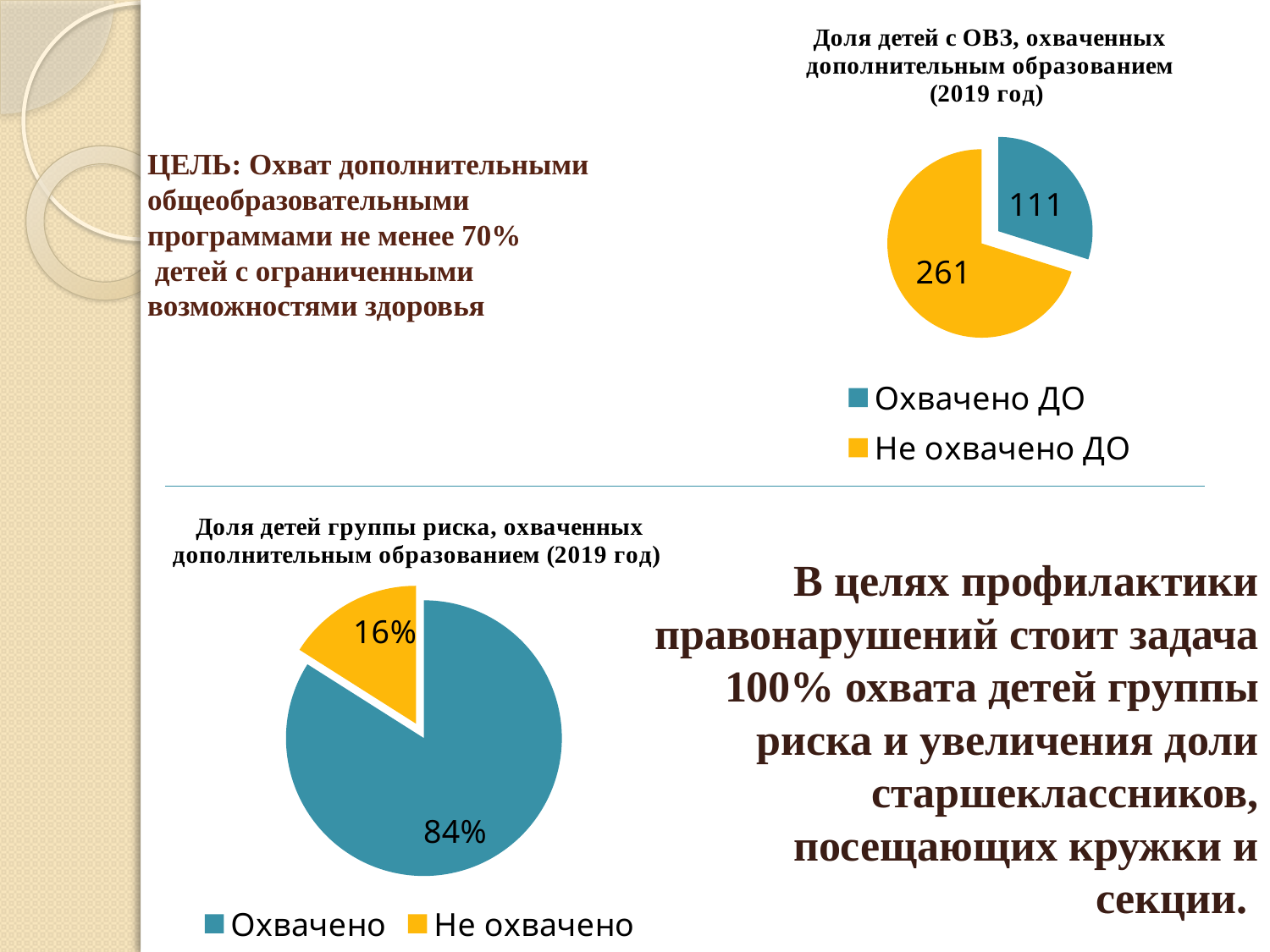
In the bottom chart 'Доля детей группы риска, охваченных дополнительным образованием (2019 год)', what is the value for 'Не охвачено'? 16% What type of chart is the top chart 'Доля детей с ОВЗ, охваченных дополнительным образованием (2019 год)'? Pie chart In the top chart 'Доля детей с ОВЗ, охваченных дополнительным образованием (2019 год)', what is the value for 'Не охвачено ДО'? 261 In the bottom chart 'Доля детей группы риска, охваченных дополнительным образованием (2019 год)', which category has the smaller share? Не охвачено In the bottom chart 'Доля детей группы риска, охваченных дополнительным образованием (2019 год)', what is the value for 'Охвачено'? 84% In the top chart 'Доля детей с ОВЗ, охваченных дополнительным образованием (2019 год)', what is the value for 'Охвачено ДО'? 111 In the top chart 'Доля детей с ОВЗ, охваченных дополнительным образованием (2019 год)', which category has the larger value? Не охвачено ДО How many entries does the legend of the top chart 'Доля детей с ОВЗ, охваченных дополнительным образованием (2019 год)' list? 2 In the top chart 'Доля детей с ОВЗ, охваченных дополнительным образованием (2019 год)', what is the difference between 'Не охвачено ДО' and 'Охвачено ДО'? 150 In the bottom chart 'Доля детей группы риска, охваченных дополнительным образованием (2019 год)', what colour is the 'Не охвачено' slice? Yellow In the bottom chart 'Доля детей группы риска, охваченных дополнительным образованием (2019 год)', what is the difference between 'Охвачено' and 'Не охвачено'? 68% In the top chart 'Доля детей с ОВЗ, охваченных дополнительным образованием (2019 год)', what is the total of the two slices? 372